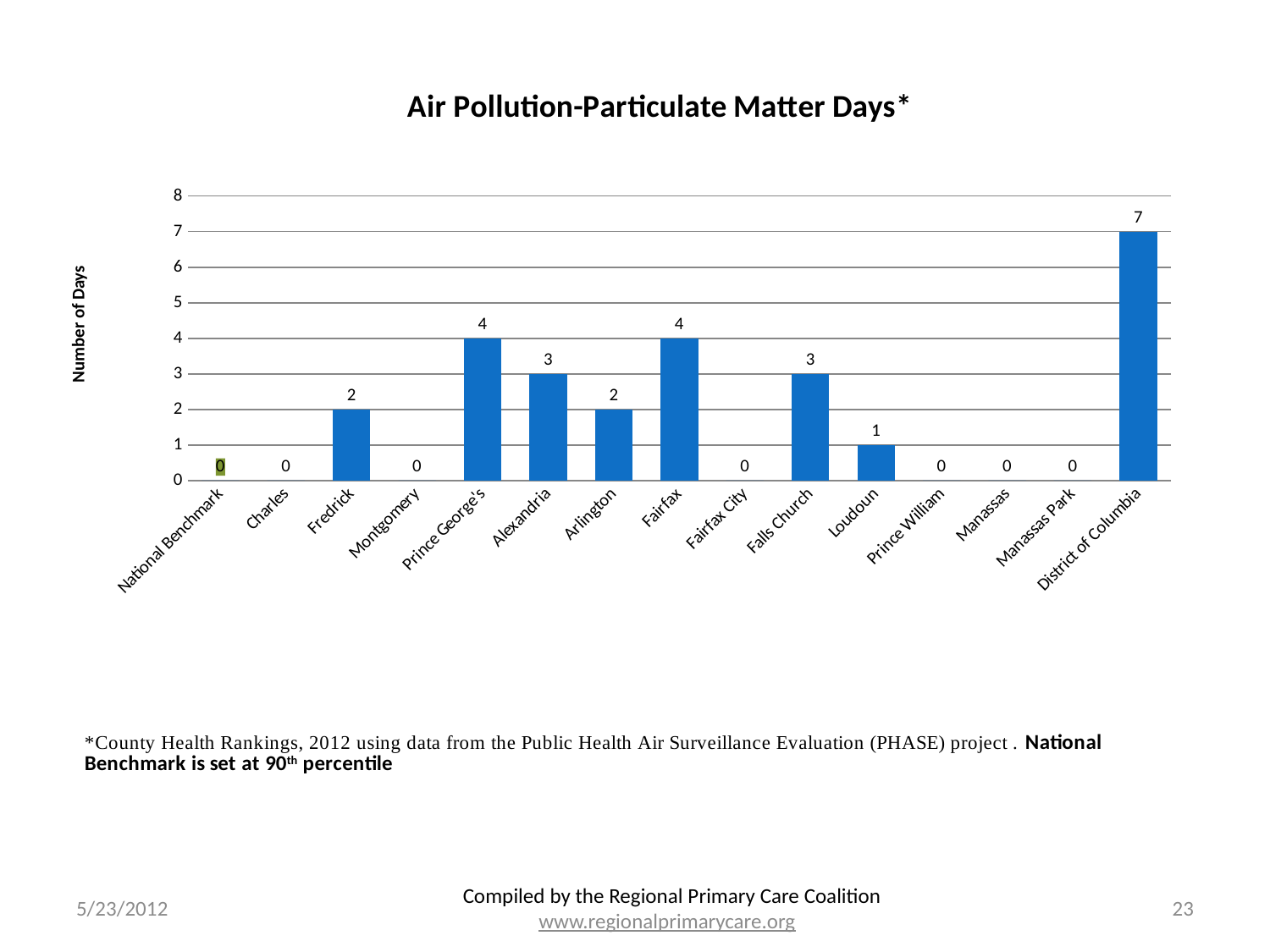
Which category has the highest value? District of Columbia What is the value for Loudoun? 1 Which is larger, the value for Alexandria or the value for Arlington? Alexandria What is the value for Fredrick? 2 What is the title of the chart? Air Pollution-Particulate Matter Days* What is the difference between the values for District of Columbia and Fairfax? 3 What is the value for Falls Church? 3 Is the value for District of Columbia greater or less than 5? greater What is the label of the y axis? Number of Days How many categories are shown on the x axis? 15 What is the value for District of Columbia? 7 What kind of chart is this? bar chart